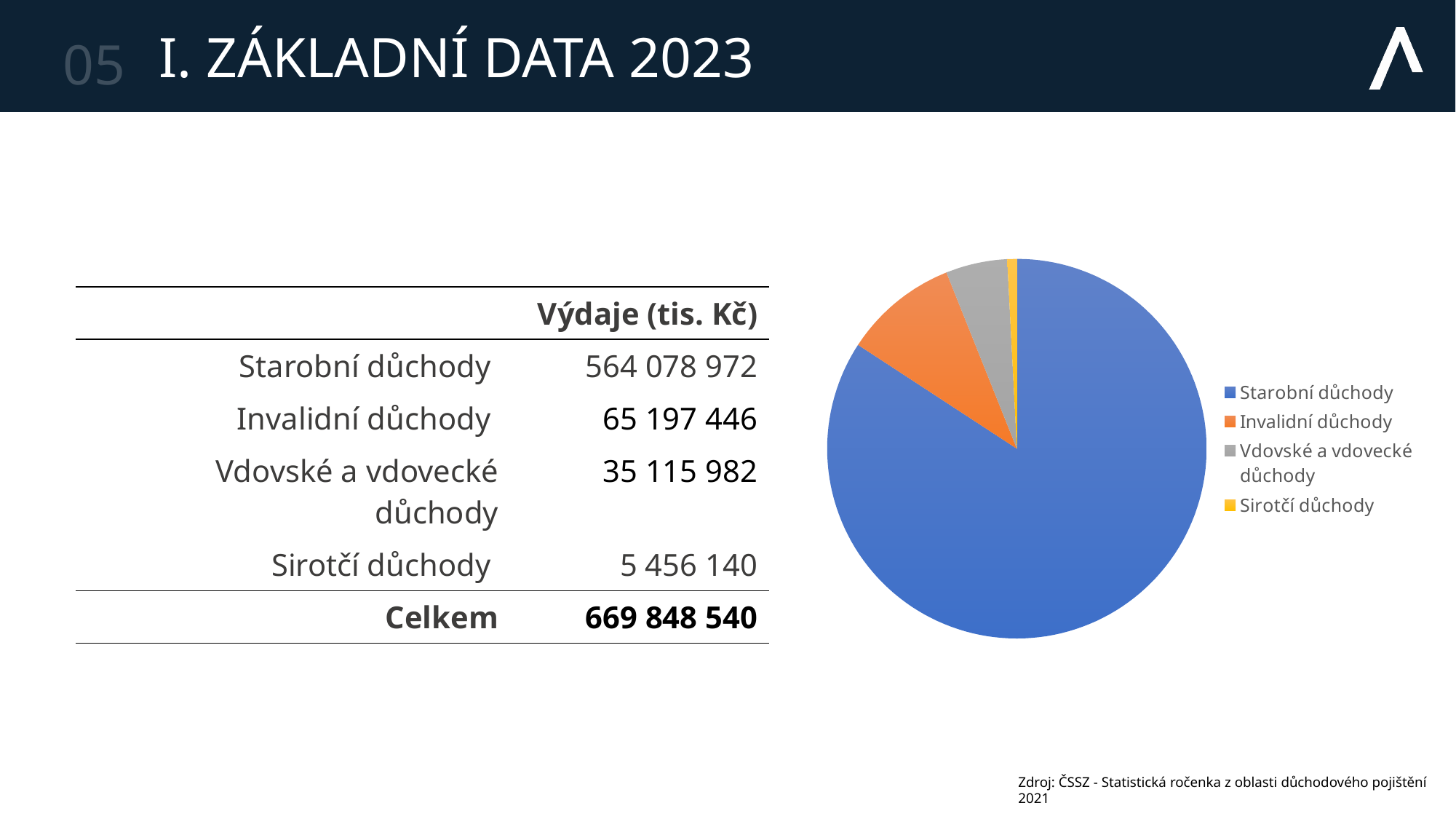
Which slice is larger in the pie chart: Invalidní důchody or Vdovské a vdovecké důchody? Invalidní důchody Which category has the largest slice in the pie chart? Starobní důchody What is the value (Výdaje, tis. Kč) for Vdovské a vdovecké důchody? 35 115 982 How many entries does the legend of the pie chart list? 4 What colour is the slice for Starobní důchody in the pie chart? blue What is the value (Výdaje, tis. Kč) for Starobní důchody? 564 078 972 How many slices does the pie chart have? 4 What is the total of all four categories shown in the pie chart (Celkem, tis. Kč)? 669 848 540 What is the value (Výdaje, tis. Kč) for Sirotčí důchody? 5 456 140 What is the difference between the values for Invalidní důchody and Vdovské a vdovecké důchody (tis. Kč)? 30 081 464 What kind of chart is shown on the slide? pie chart Which category has the smallest slice in the pie chart? Sirotčí důchody